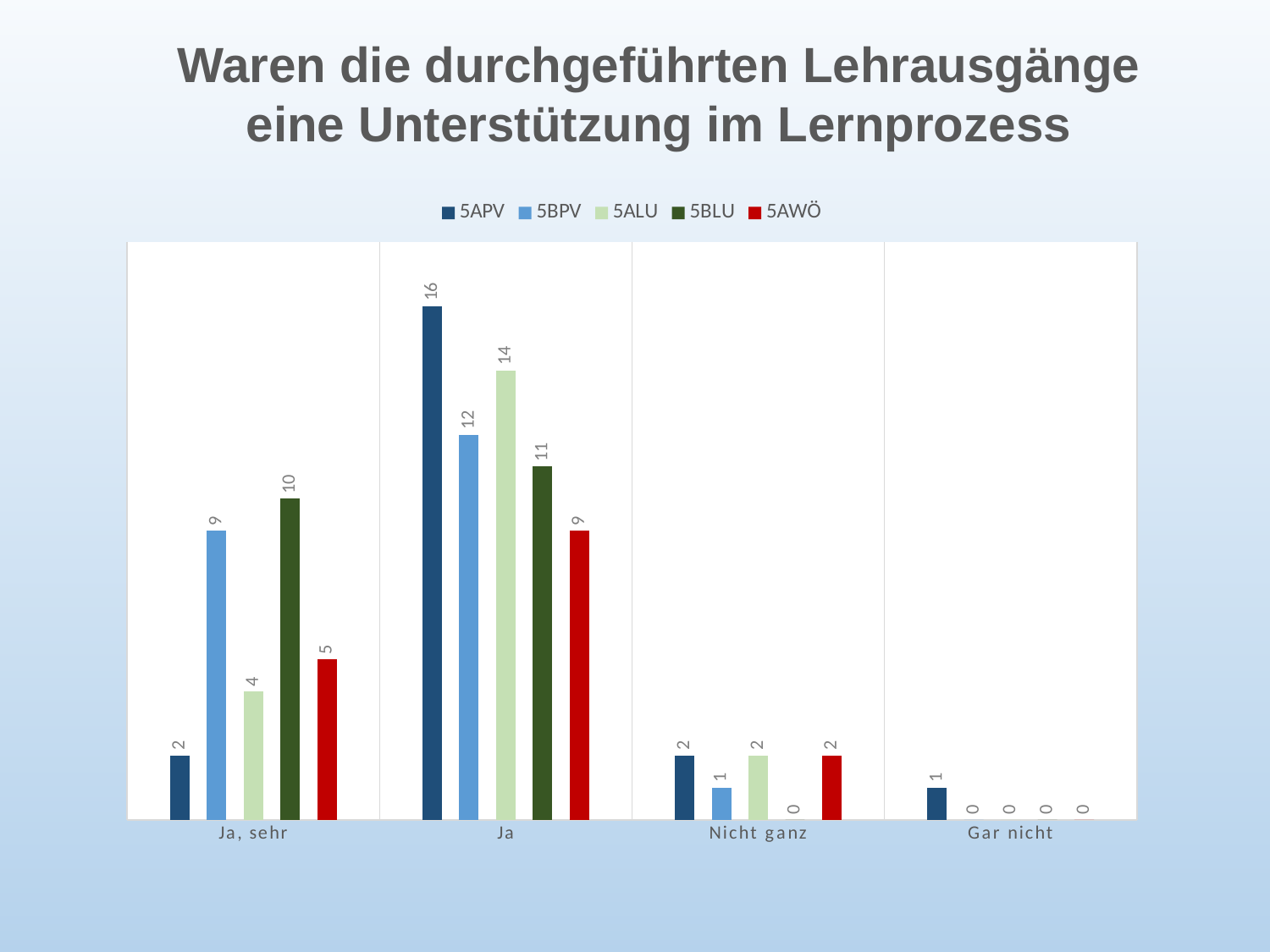
What is the value for 5APV in the "Ja" category? 16 What is the value for 5BLU in the "Ja, sehr" category? 10 Which is larger in the "Ja, sehr" category: 5BPV or 5ALU? 5BPV What is the value for 5AWÖ in the "Nicht ganz" category? 2 What is the title of the chart? Waren die durchgeführten Lehrausgänge eine Unterstützung im Lernprozess What kind of chart is shown on the slide? bar chart Which series has the lowest value in the "Ja" category? 5AWÖ Which series has the highest value in the "Ja, sehr" category? 5BLU What is the difference between the 5APV and 5BPV values in the "Ja" category? 4 How many series does the legend list? 5 How many categories are shown on the x axis? 4 What is the value for 5ALU in the "Gar nicht" category? 0